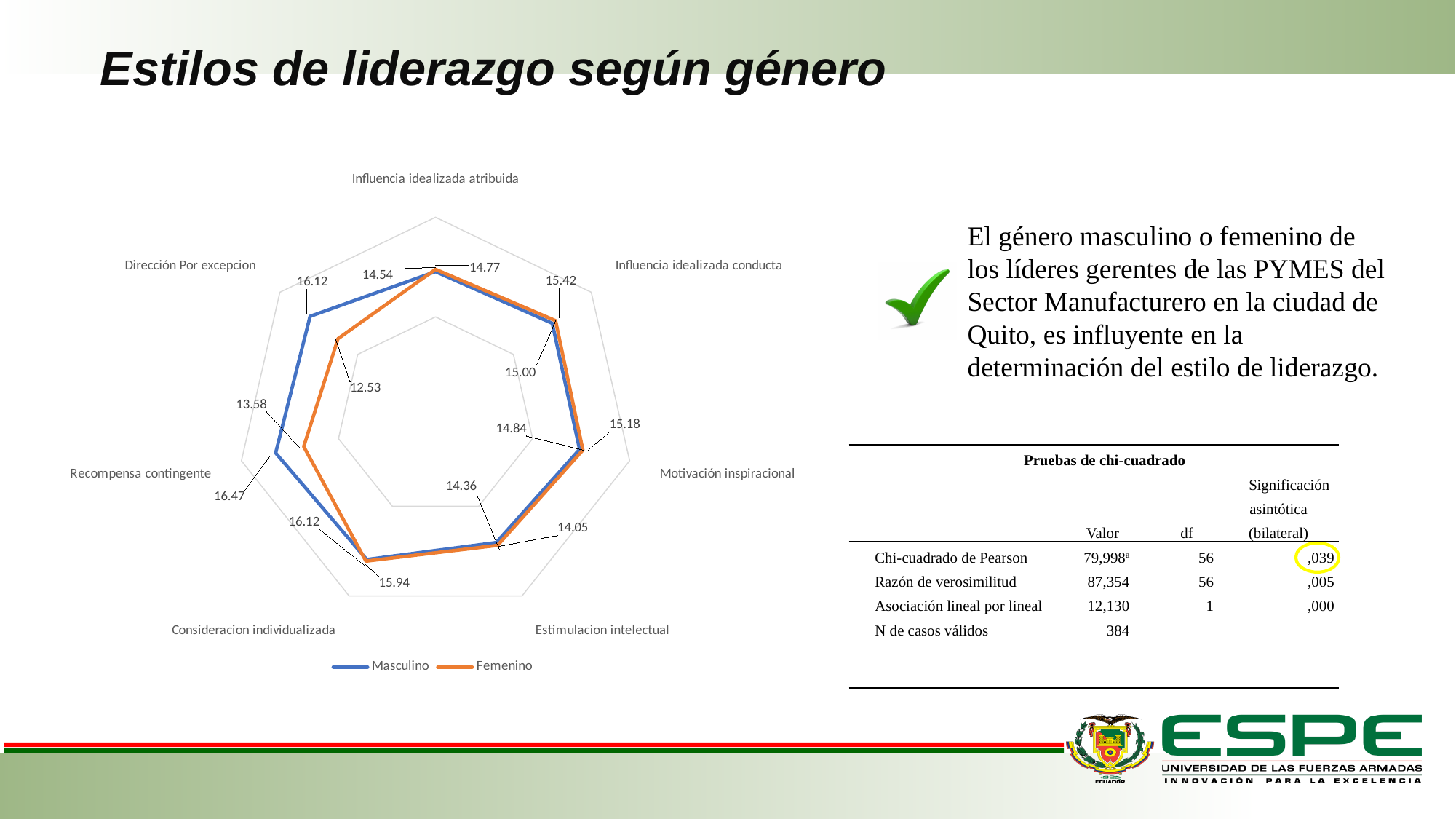
In which category does the Femenino series have its lowest value? Dirección Por excepcion What is the difference between the Masculino and Femenino values for Dirección Por excepcion? 3.59 Which series has the higher value for Recompensa contingente, Masculino or Femenino? Masculino What is the difference between the Masculino and Femenino values for Recompensa contingente? 2.89 What is the Femenino value for Recompensa contingente? 13.58 How many series does the chart legend list? 2 What kind of chart is shown on the slide? Radar chart What is the Masculino value for Dirección Por excepcion? 16.12 What is the Masculino value for Recompensa contingente? 16.47 How many categories (axes) does the radar chart have? 7 What is the Femenino value for Dirección Por excepcion? 12.53 What are the two series named in the chart legend? Masculino and Femenino